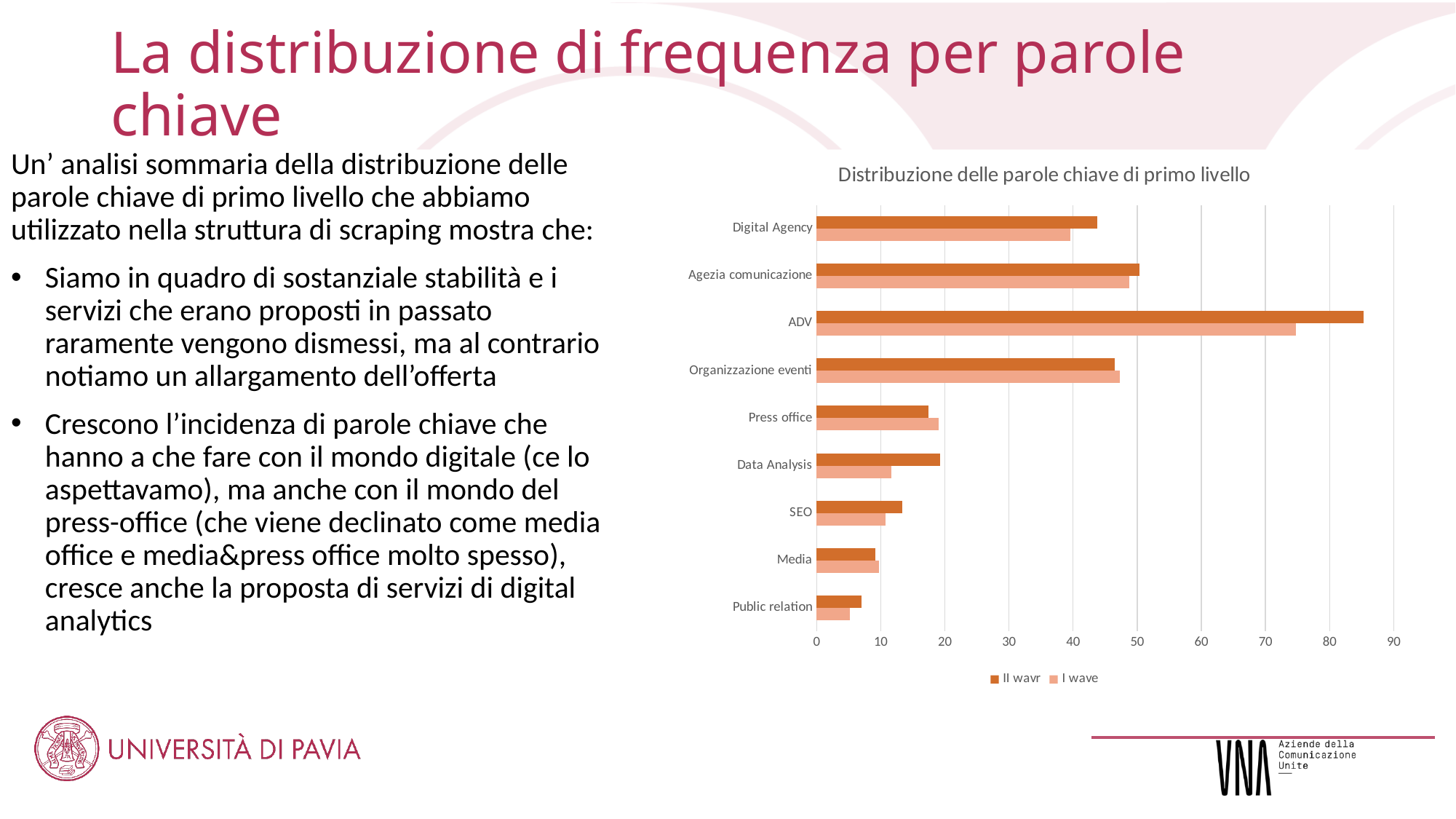
Is the II wavr value for Digital Agency greater or less than 40? greater How many series does the chart legend list? 2 What kind of chart is shown on the slide? bar chart For Data Analysis, which series has the larger value, II wavr or I wave? II wavr Which category has the lowest value for the I wave series? Public relation Which series is shown in the darker orange colour in the legend? II wavr Is the II wavr value for ADV greater or less than 80? greater For ADV, which series has the larger value, II wavr or I wave? II wavr What is the title of the chart? Distribuzione delle parole chiave di primo livello Which category has the highest value for the II wavr series? ADV How many categories are shown on the chart? 9